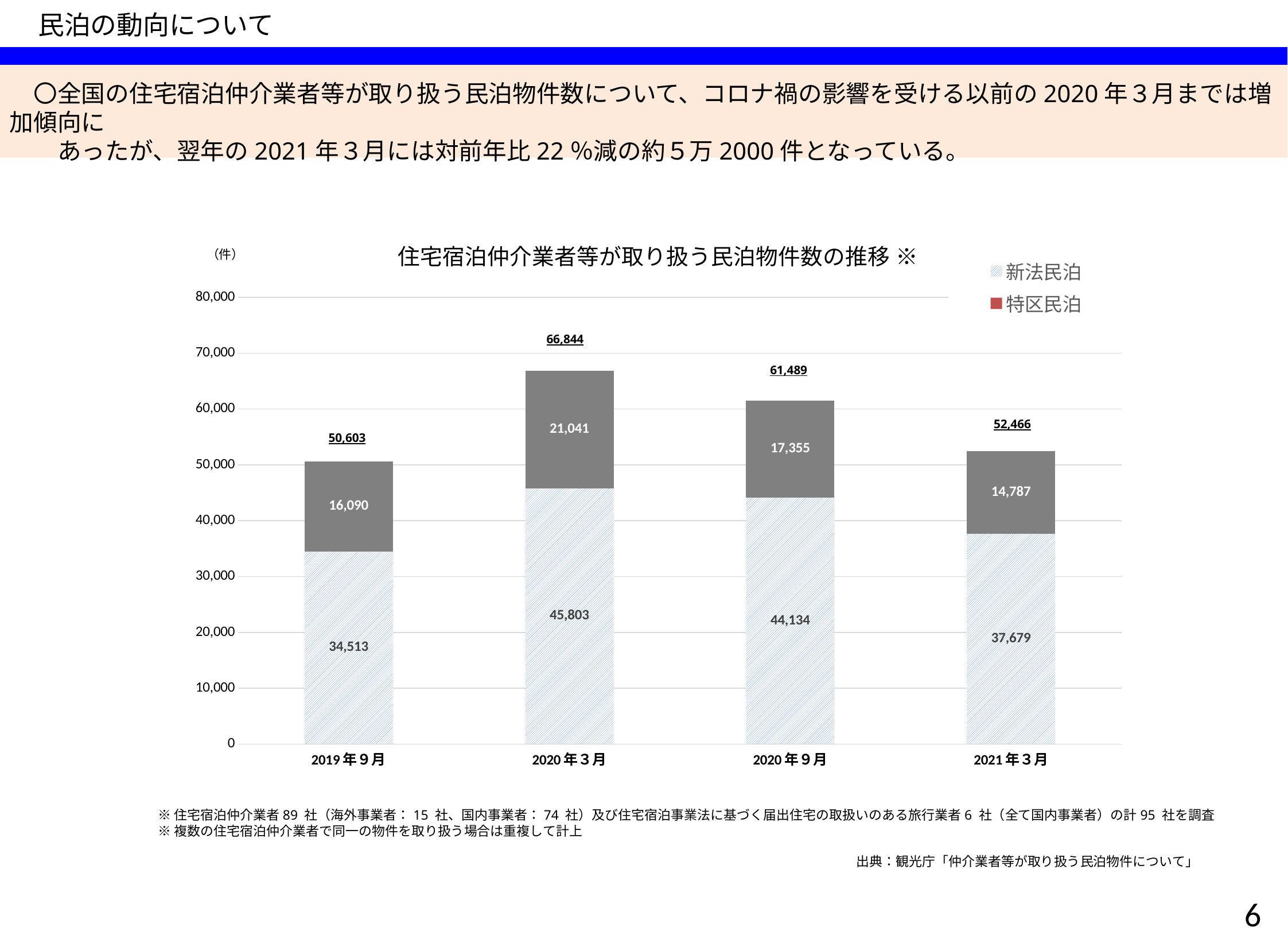
What is the title of the chart? 住宅宿泊仲介業者等が取り扱う民泊物件数の推移 ※ What is the difference between the total for 2020年3月 and the total for 2021年3月? 14,378 Is the total for 2020年9月 greater or less than 60,000? greater Which period has the highest total number of properties? 2020年3月 What is the value of 特区民泊 for 2021年3月? 14,787 How many series does the chart legend list? 2 What kind of chart is shown on the slide? Stacked bar chart What is the value of 新法民泊 for 2020年3月? 45,803 Which period has the lowest value for 新法民泊? 2019年9月 What is the total number of properties shown for 2019年9月? 50,603 How many time periods are shown on the x axis of the chart? 4 Which is larger: 特区民泊 in 2020年9月 or 特区民泊 in 2019年9月? 2020年9月